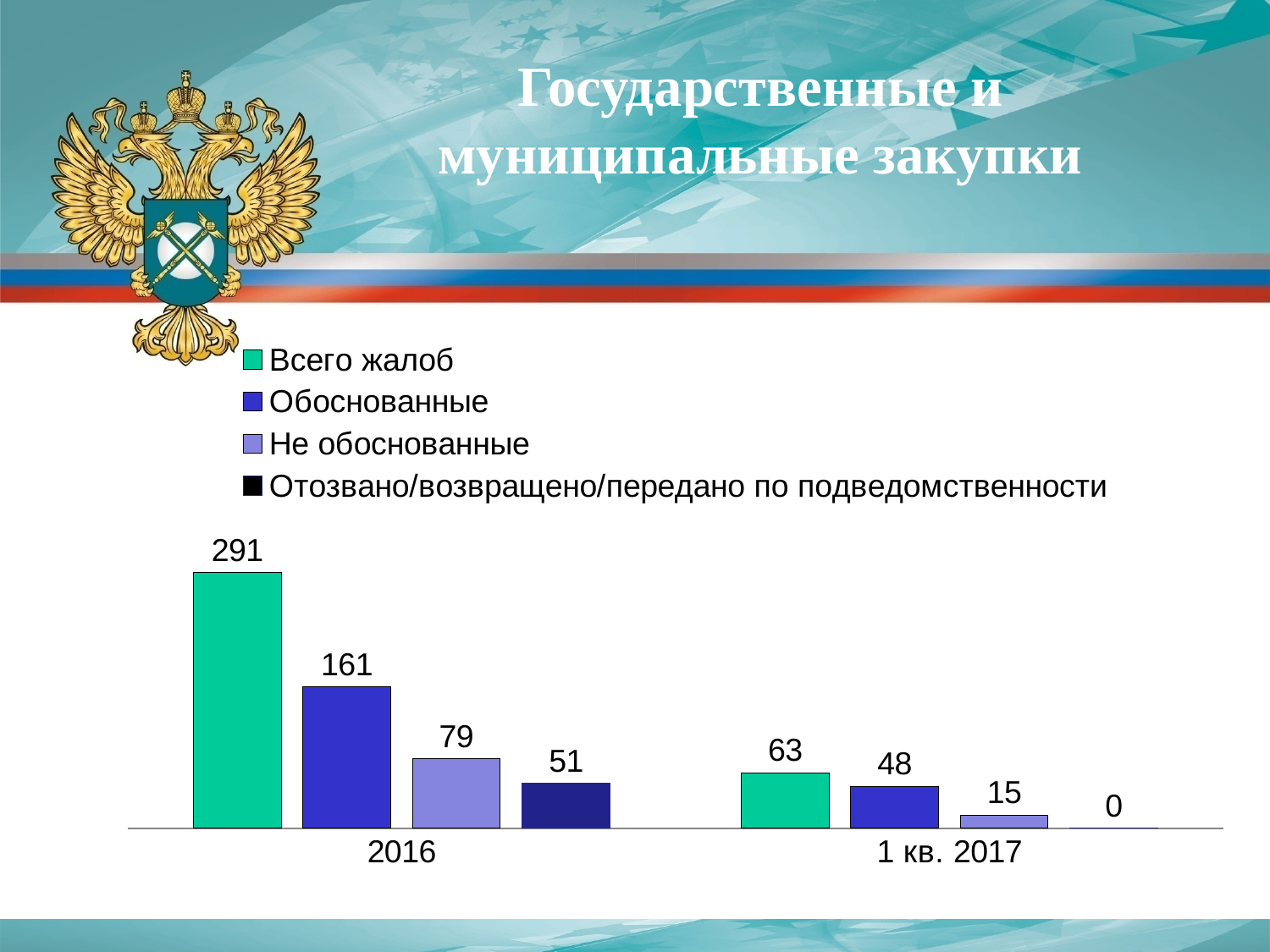
How many categories are shown on the x axis? 2 Which series has the highest value in 2016? Всего жалоб What is the difference between "Всего жалоб" in 2016 and in 1 кв. 2017? 228 What is the value of "Обоснованные" for 1 кв. 2017? 48 What is the value of "Не обоснованные" for 2016? 79 What kind of chart is shown on the slide? Bar chart How many series does the legend list? 4 What is the value of "Отозвано/возвращено/передано по подведомственности" for 1 кв. 2017? 0 Which series has the lowest value in 1 кв. 2017? Отозвано/возвращено/передано по подведомственности What is the difference between "Всего жалоб" and "Обоснованные" in 2016? 130 What is the value of "Всего жалоб" for 2016? 291 Which is larger: "Не обоснованные" in 2016 or "Всего жалоб" in 1 кв. 2017? Не обоснованные in 2016